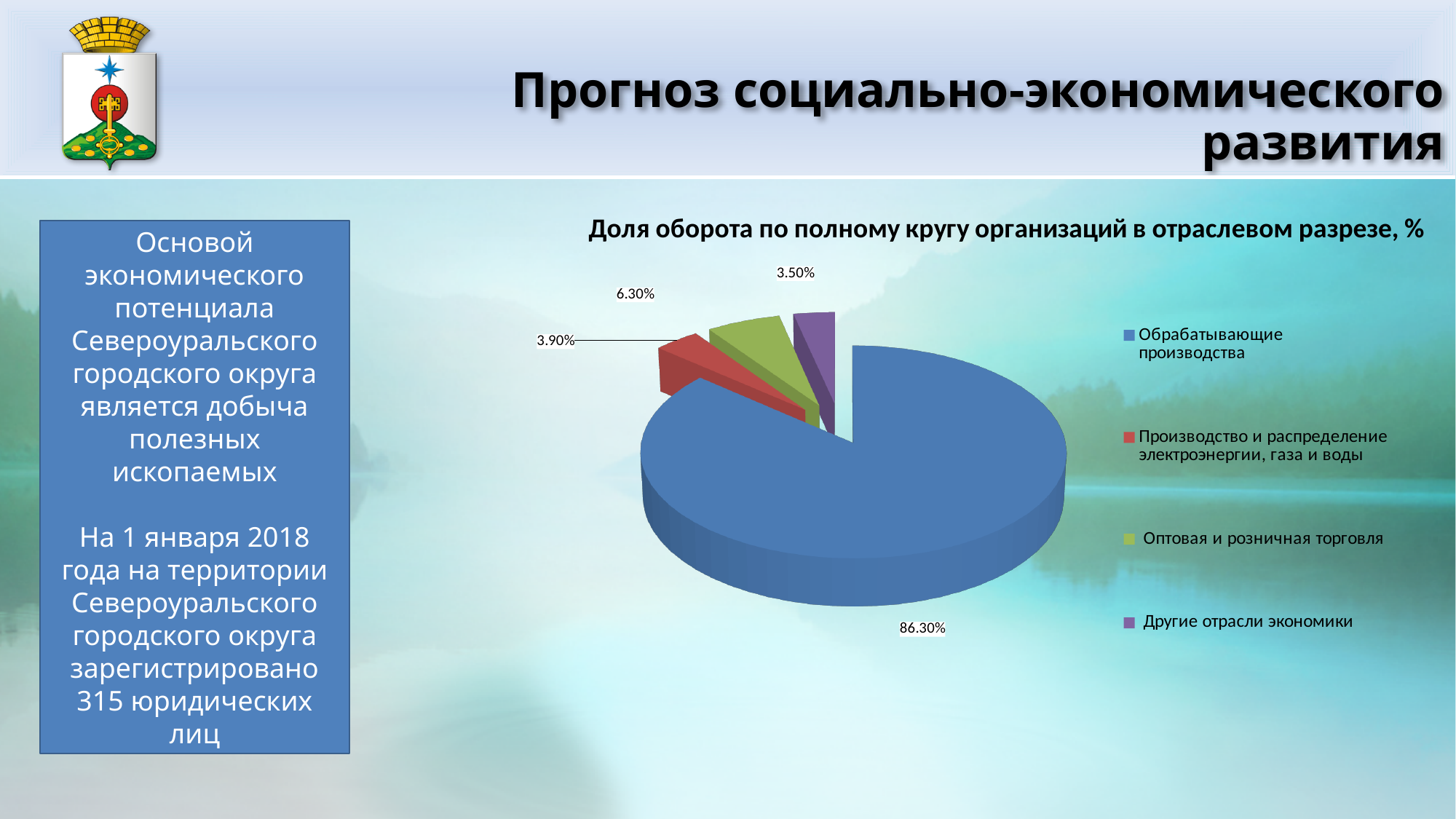
What share does the slice for Производство и распределение электроэнергии, газа и воды have? 3.90% What share does the slice for Оптовая и розничная торговля have? 6.30% What is the title of the chart? Доля оборота по полному кругу организаций в отраслевом разрезе, % What share does the slice for Обрабатывающие производства have? 86.30% Which category has the largest slice of the pie? Обрабатывающие производства What is the difference between the shares of Обрабатывающие производства and Оптовая и розничная торговля? 80.00% Which category has the smallest slice of the pie? Другие отрасли экономики What colour is the slice for Другие отрасли экономики? Purple How many slices does the pie chart have? 4 What share does the slice for Другие отрасли экономики have? 3.50% Which is larger: the slice for Оптовая и розничная торговля or the slice for Производство и распределение электроэнергии, газа и воды? Оптовая и розничная торговля What kind of chart is shown on the slide? Pie chart